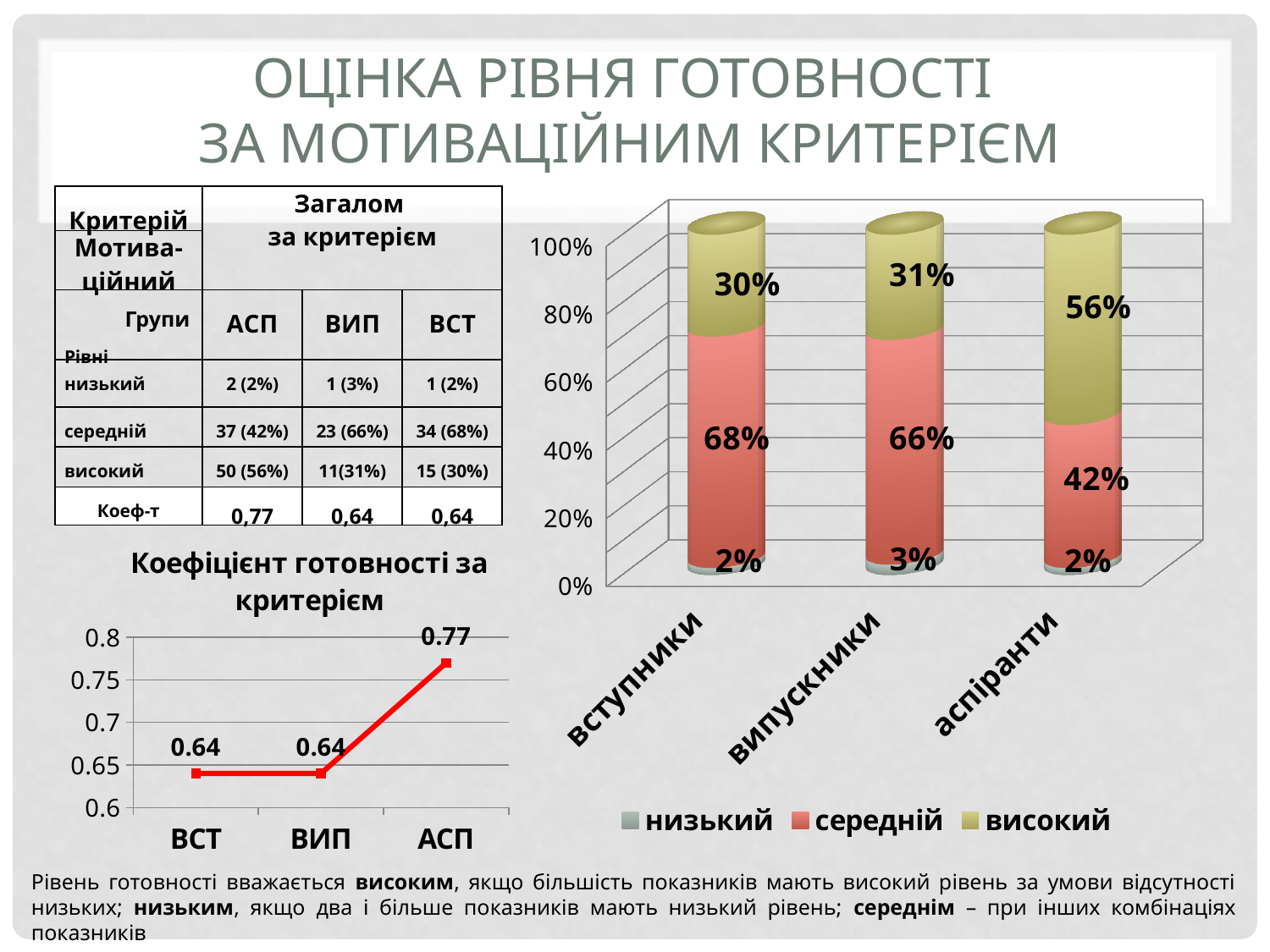
In the stacked bar chart on the right, what is the value of the середній segment for випускники? 66% In the chart titled 'Коефіцієнт готовності за критерієм', what is the value for ВСТ? 0.64 In the chart titled 'Коефіцієнт готовності за критерієм', what is the difference between the values for АСП and ВИП? 0.13 In the stacked bar chart on the right, how many categories are shown on the x axis? 3 In the stacked bar chart on the right, how many series does the legend list? 3 In the stacked bar chart on the right, what is the difference between the середній values for вступники and аспіранти? 26% In the stacked bar chart on the right, what is the value of the високий segment for аспіранти? 56% What kind of chart is the chart titled 'Коефіцієнт готовності за критерієм'? line chart In the stacked bar chart on the right, which category has the lowest середній value? аспіранти In the stacked bar chart on the right, which category has the highest високий value? аспіранти In the chart titled 'Коефіцієнт готовності за критерієм', what is the value for АСП? 0.77 In the stacked bar chart on the right, what is the value of the низький segment for вступники? 2%